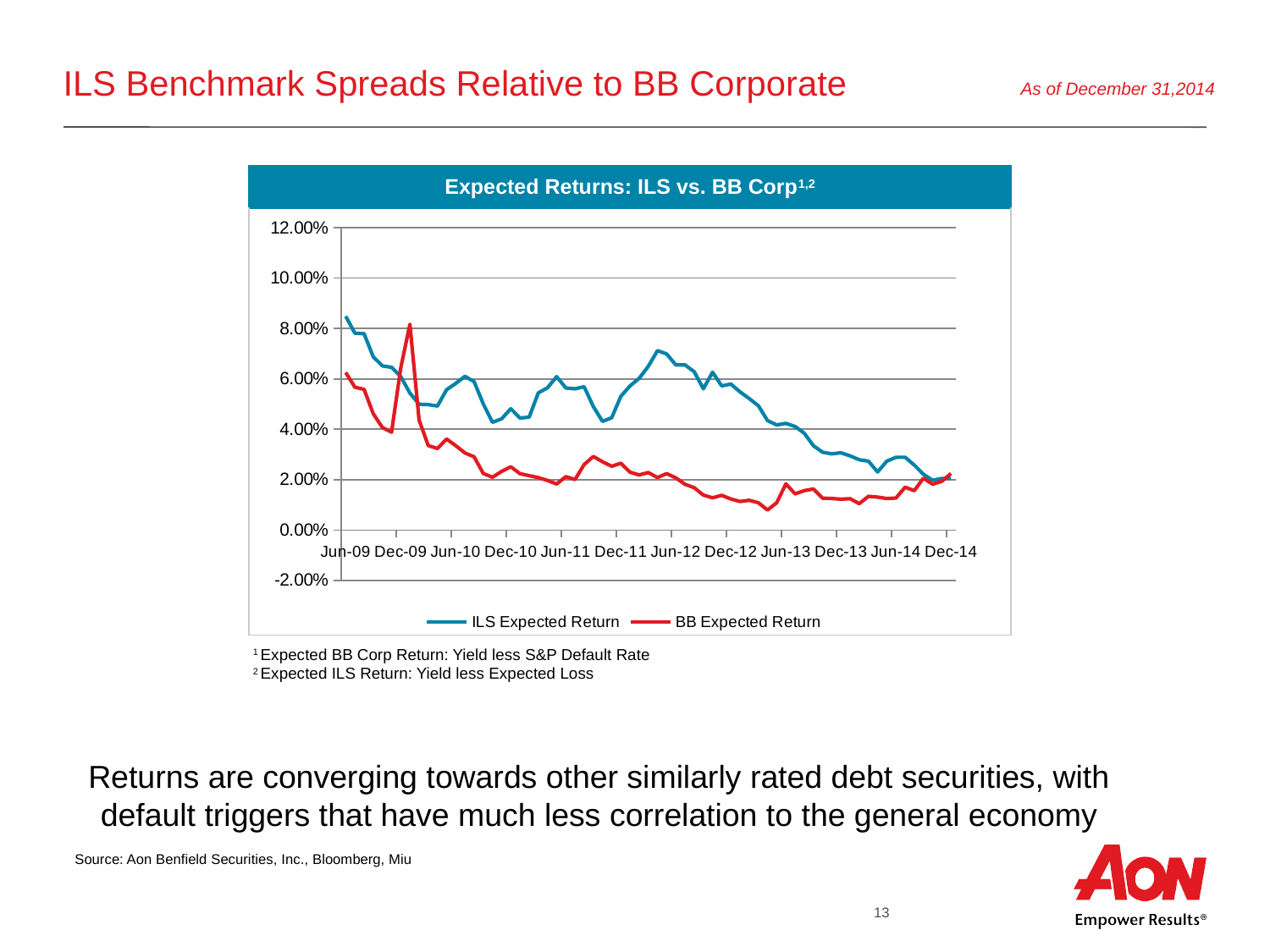
Is the BB Expected Return at Jun-09 greater or less than 4.00%? greater How many series does the legend list? 2 What is the title of the chart? Expected Returns: ILS vs. BB Corp Does the ILS Expected Return line overall rise or fall from Jun-09 to Dec-14? Fall How many date labels are shown on the x axis? 12 Does the BB Expected Return line overall rise or fall from Jun-09 to Dec-14? Fall Is the ILS Expected Return at Jun-09 greater or less than 6.00%? greater Which colour is used for the BB Expected Return line? Red What kind of chart is shown on the slide? Line chart Is the BB Expected Return at Dec-12 greater or less than 2.00%? less At Jun-12, which series has the higher expected return, ILS Expected Return or BB Expected Return? ILS Expected Return